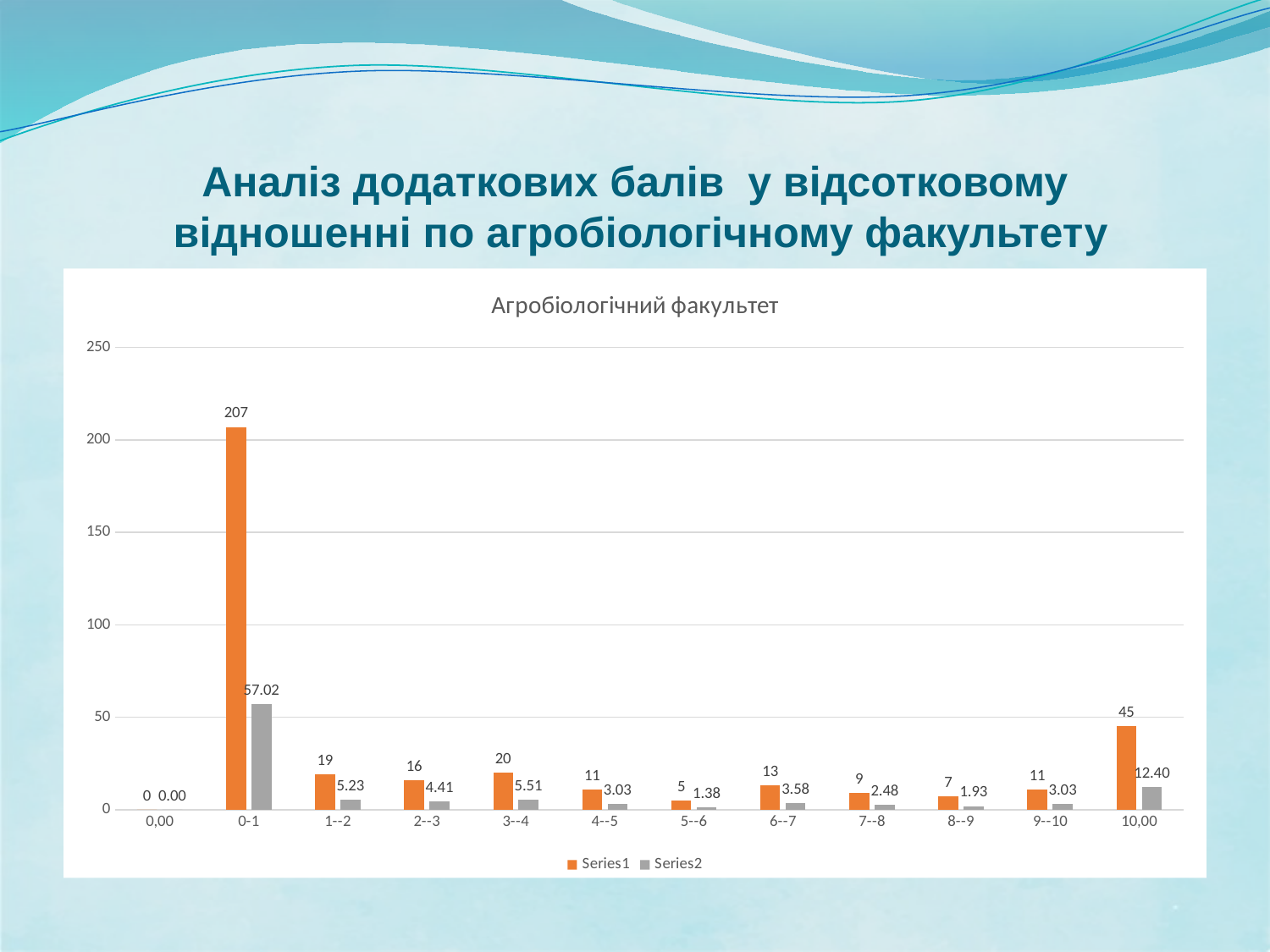
What is the Series1 value for the category 0-1? 207 How many categories are shown on the x axis? 12 What type of chart is shown on the slide? Bar chart Which is larger, the Series1 value for 1--2 or for 2--3? 1--2 What is the difference between the Series1 values for 0-1 and 10,00? 162 Which category has the lowest Series1 value? 0,00 How many series does the legend list? 2 What is the Series2 value for the category 5--6? 1.38 What is the Series2 value for the category 10,00? 12.40 Is the Series2 value for 0-1 greater or less than 50? greater What is the Series1 value for the category 3--4? 20 Which category has the highest Series1 value? 0-1